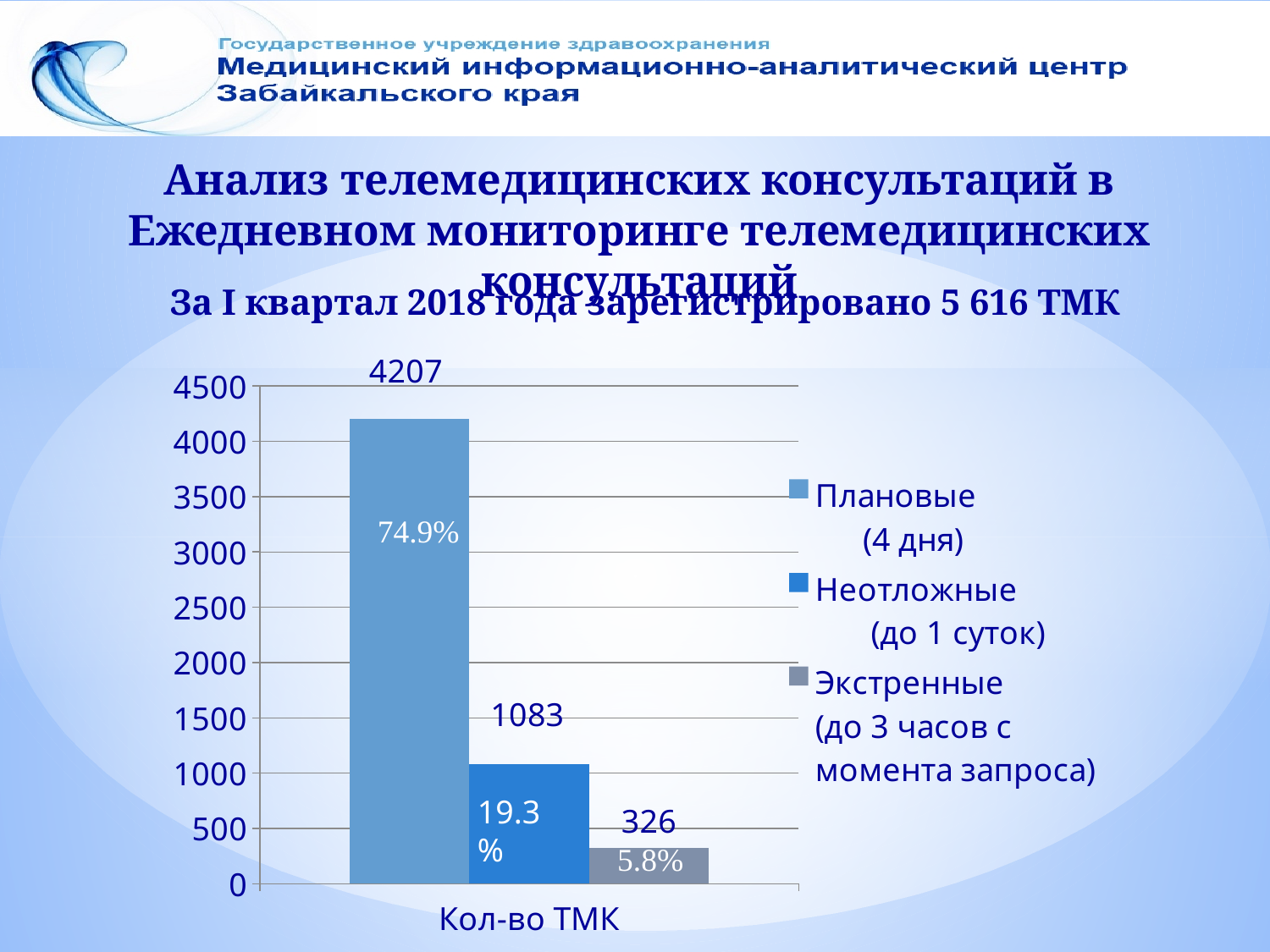
What percentage is shown on the bar for Плановые (4 дня)? 74.9% What is the value for Плановые (4 дня) in the chart? 4207 Which series has the highest value in the chart? Плановые (4 дня) What percentage is shown on the bar for Экстренные? 5.8% What is the value for Экстренные (до 3 часов с момента запроса) in the chart? 326 What is the value for Неотложные (до 1 суток) in the chart? 1083 Which is larger, the value for Неотложные or the value for Экстренные? Неотложные What kind of chart is shown on the slide? Bar chart How many series does the legend list? 3 What is the difference between the values for Плановые and Неотложные? 3124 What is the label of the category on the x axis? Кол-во ТМК Which series has the lowest value in the chart? Экстренные (до 3 часов с момента запроса)